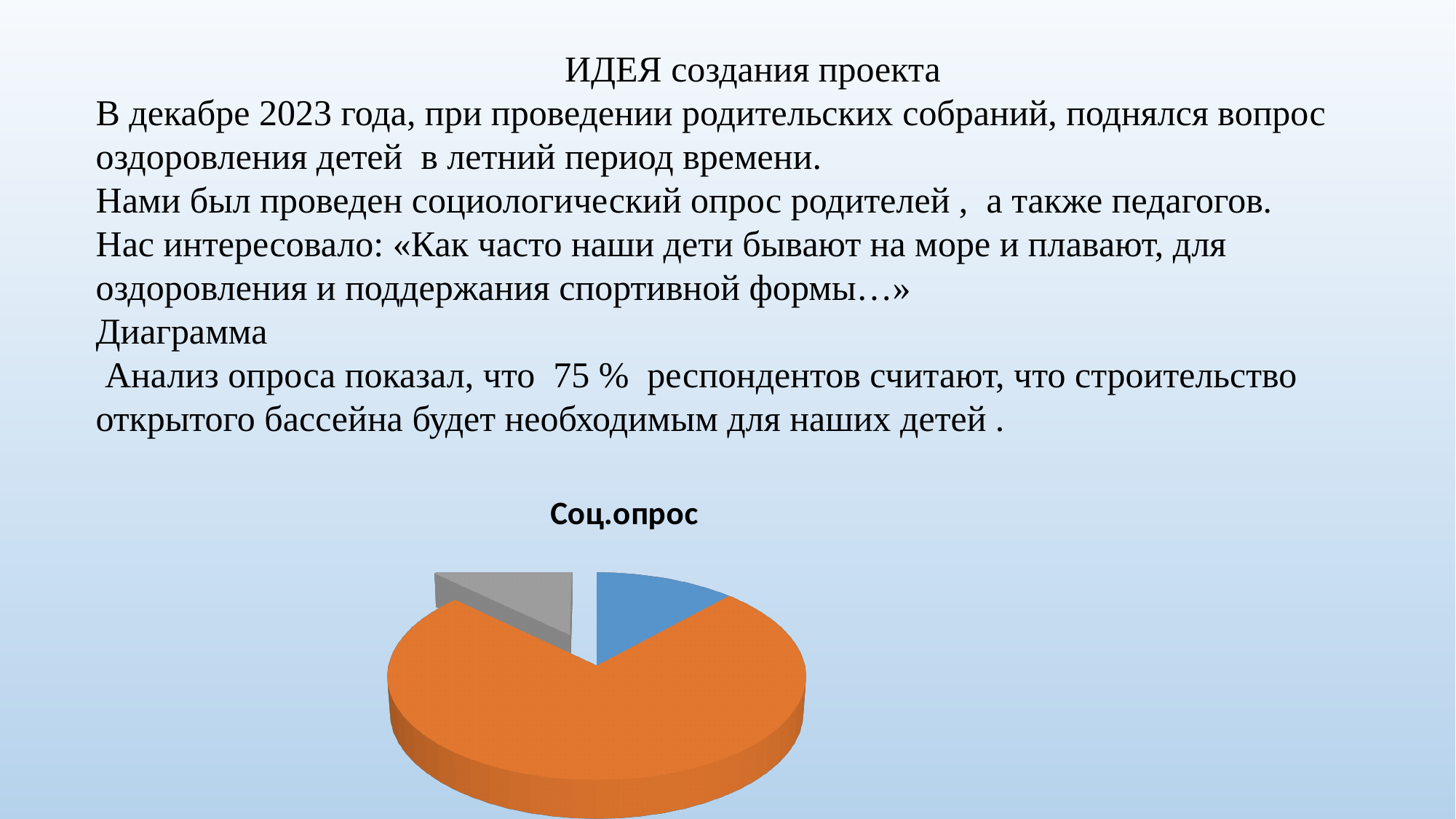
Does the orange slice take up more or less than half of the pie? more How many slices does the pie chart have? 3 What kind of chart is shown on the slide? pie chart Which is larger in the pie chart, the orange slice or the blue slice? orange What is the title of the chart? Соц.опрос Which colour slice is the largest in the pie chart? orange Does the pie chart display a legend? no Which is larger in the pie chart, the orange slice or the gray slice? orange